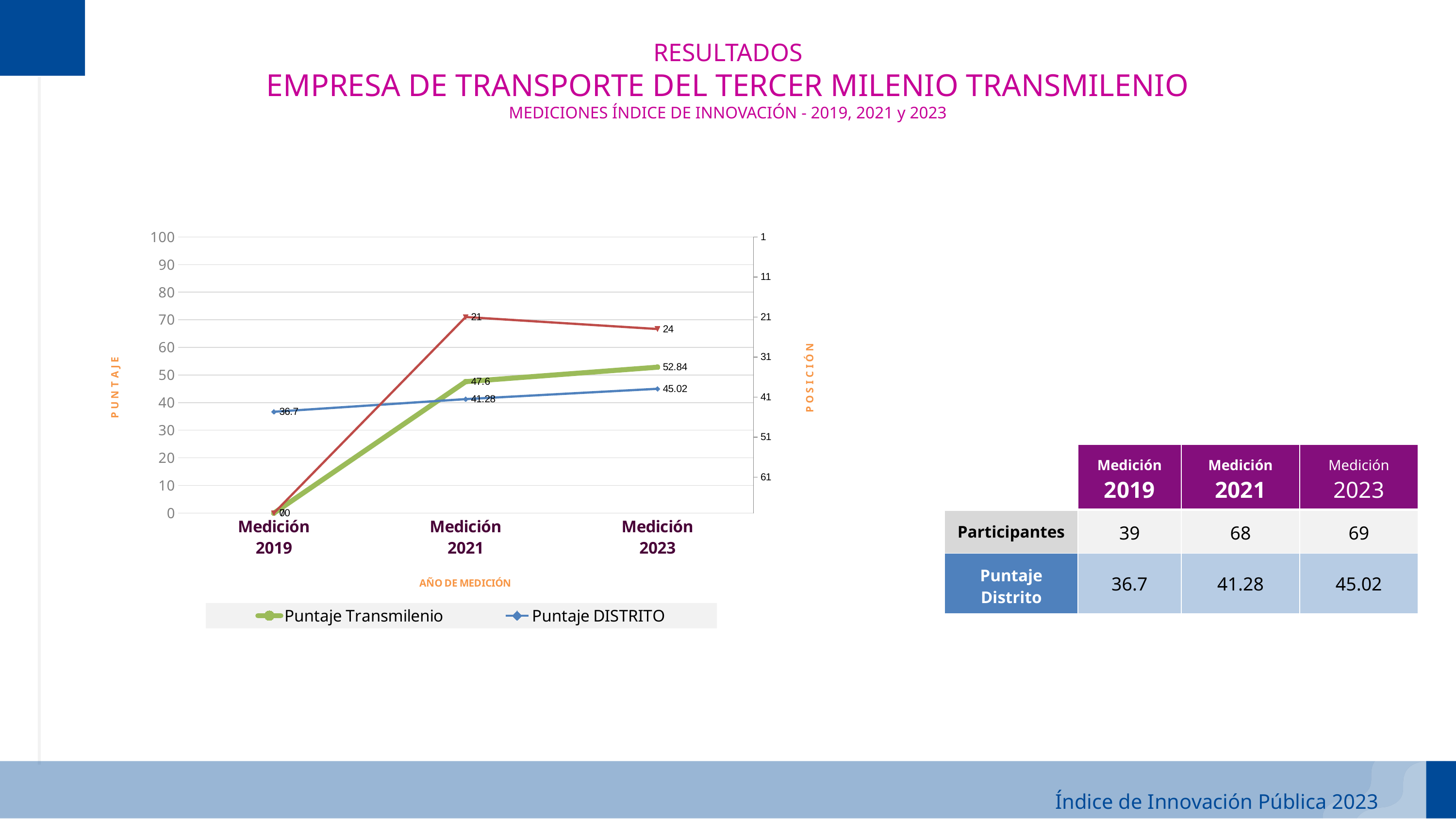
How many series does the chart legend list? 2 How many measurement years are shown on the x axis of the chart? 3 What is the Puntaje Transmilenio value for Medición 2023? 52.84 What is the difference between Puntaje Transmilenio and Puntaje DISTRITO in Medición 2023? 7.82 In which measurement year is the Puntaje Transmilenio highest? Medición 2023 What is the Puntaje DISTRITO value for Medición 2019? 36.7 In which measurement year is the Puntaje DISTRITO lowest? Medición 2019 Does the Puntaje DISTRITO rise or fall from Medición 2019 to Medición 2023? rise Which is larger in Medición 2021: Puntaje Transmilenio or Puntaje DISTRITO? Puntaje Transmilenio What is the Puntaje Transmilenio value for Medición 2021? 47.6 What is the Puntaje DISTRITO value for Medición 2021? 41.28 What type of chart is shown on the slide? line chart